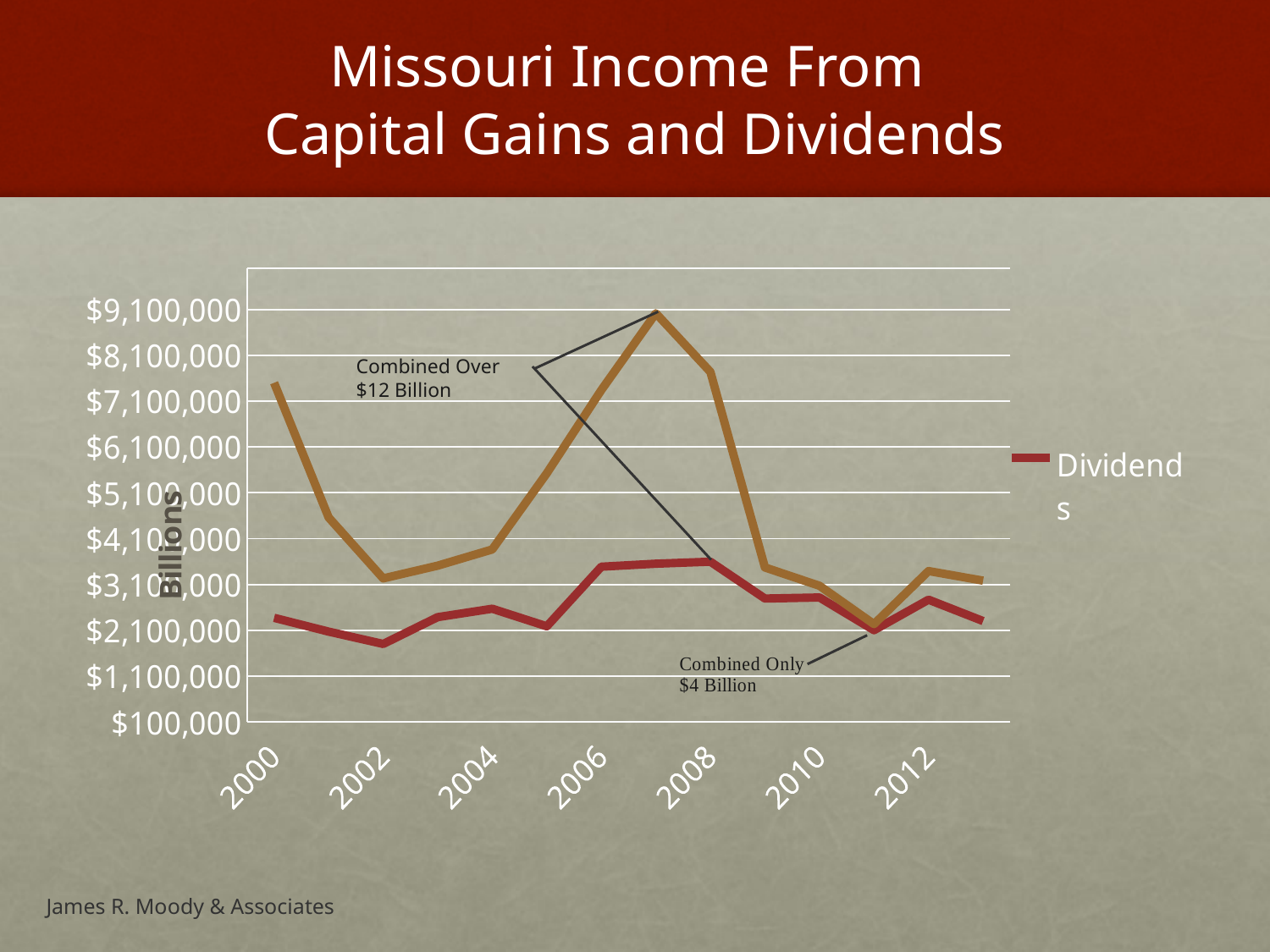
In 2000, which line is higher, the gold line or the Dividends line? the gold line In 2012, which line is higher, the gold line or the Dividends line? the gold line What kind of chart is shown on the slide? line chart Is the Dividends value for 2000 greater or less than $3,100,000? less Is the Dividends value for 2002 greater or less than $2,100,000? less How many year labels are shown on the x axis? 7 Is the Dividends value for 2006 greater or less than $3,100,000? greater Does the Dividends line rise or fall from 2008 to 2010? fall What does the annotation pointing to the peak of the gold line say? Combined Over $12 Billion Does the gold line rise or fall from 2000 to 2002? fall